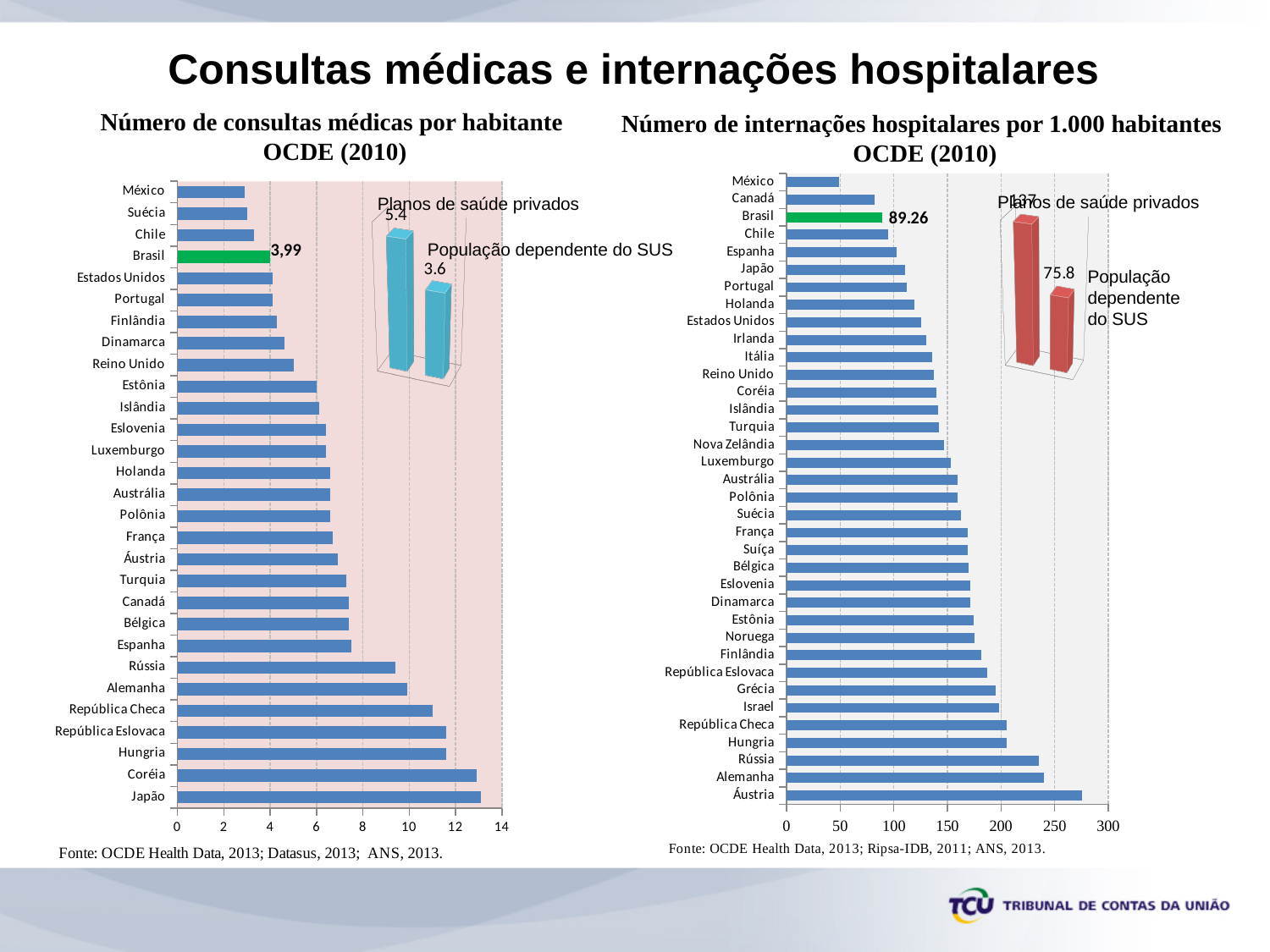
In the chart 'Número de internações hospitalares por 1.000 habitantes OCDE (2010)', is the value for Áustria greater or less than 250? greater In the small inset chart on the left side of the slide, what is the difference between 'Planos de saúde privados' and 'População dependente do SUS'? 1.8 In the chart 'Número de internações hospitalares por 1.000 habitantes OCDE (2010)', which country has the lowest value? México In the chart 'Número de internações hospitalares por 1.000 habitantes OCDE (2010)', which country has the highest value? Áustria In the chart 'Número de consultas médicas por habitante OCDE (2010)', which country has the highest number of consultations? Japão What kind of chart is 'Número de consultas médicas por habitante OCDE (2010)'? bar chart In the chart 'Número de internações hospitalares por 1.000 habitantes OCDE (2010)', what is the value for Brasil? 89.26 In the chart 'Número de consultas médicas por habitante OCDE (2010)', which country has the lowest number of consultations? México In the chart 'Número de consultas médicas por habitante OCDE (2010)', is the value for Japão greater or less than 12? greater In the chart 'Número de consultas médicas por habitante OCDE (2010)', what is the value for Brasil? 3,99 In the chart 'Número de internações hospitalares por 1.000 habitantes OCDE (2010)', is the value for Alemanha greater or less than 200? greater In the small inset chart on the left side of the slide, what is the value for 'Planos de saúde privados'? 5.4